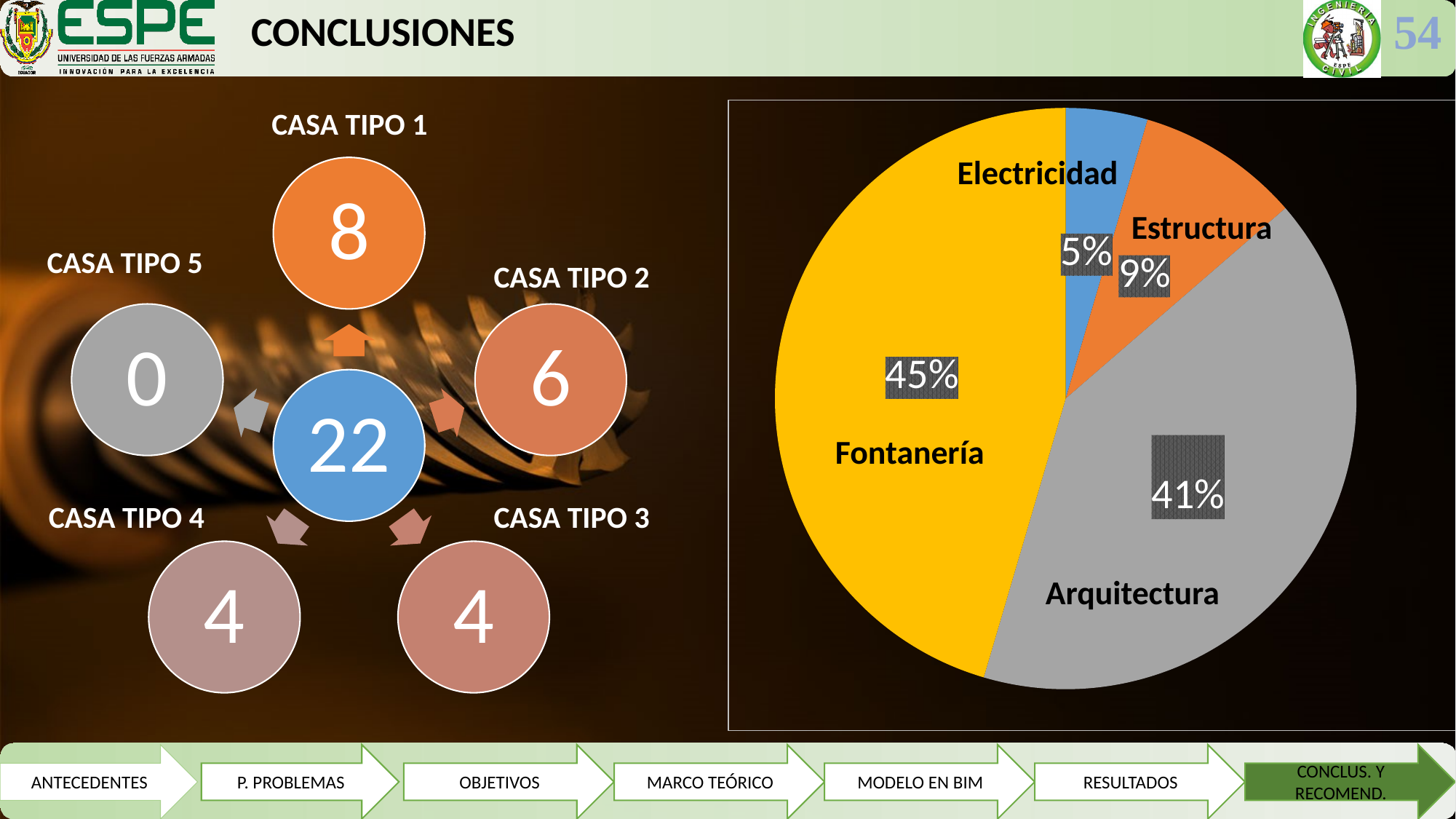
In the pie chart, what is the difference in percentage points between Fontanería and Arquitectura? 4 How many slices does the pie chart have? 4 What colour is the Arquitectura slice in the pie chart? grey In the pie chart, what percentage is shown for Arquitectura? 41% In the pie chart, what percentage is shown for Fontanería? 45% In the pie chart, what percentage is shown for Electricidad? 5% What kind of chart is shown on the right side of the slide? pie chart In the pie chart, what percentage is shown for Estructura? 9% Which slice of the pie chart is the largest? Fontanería In the pie chart, which is larger: Estructura or Electricidad? Estructura Which slice of the pie chart is the smallest? Electricidad In the pie chart, what is the difference in percentage points between Estructura and Electricidad? 4